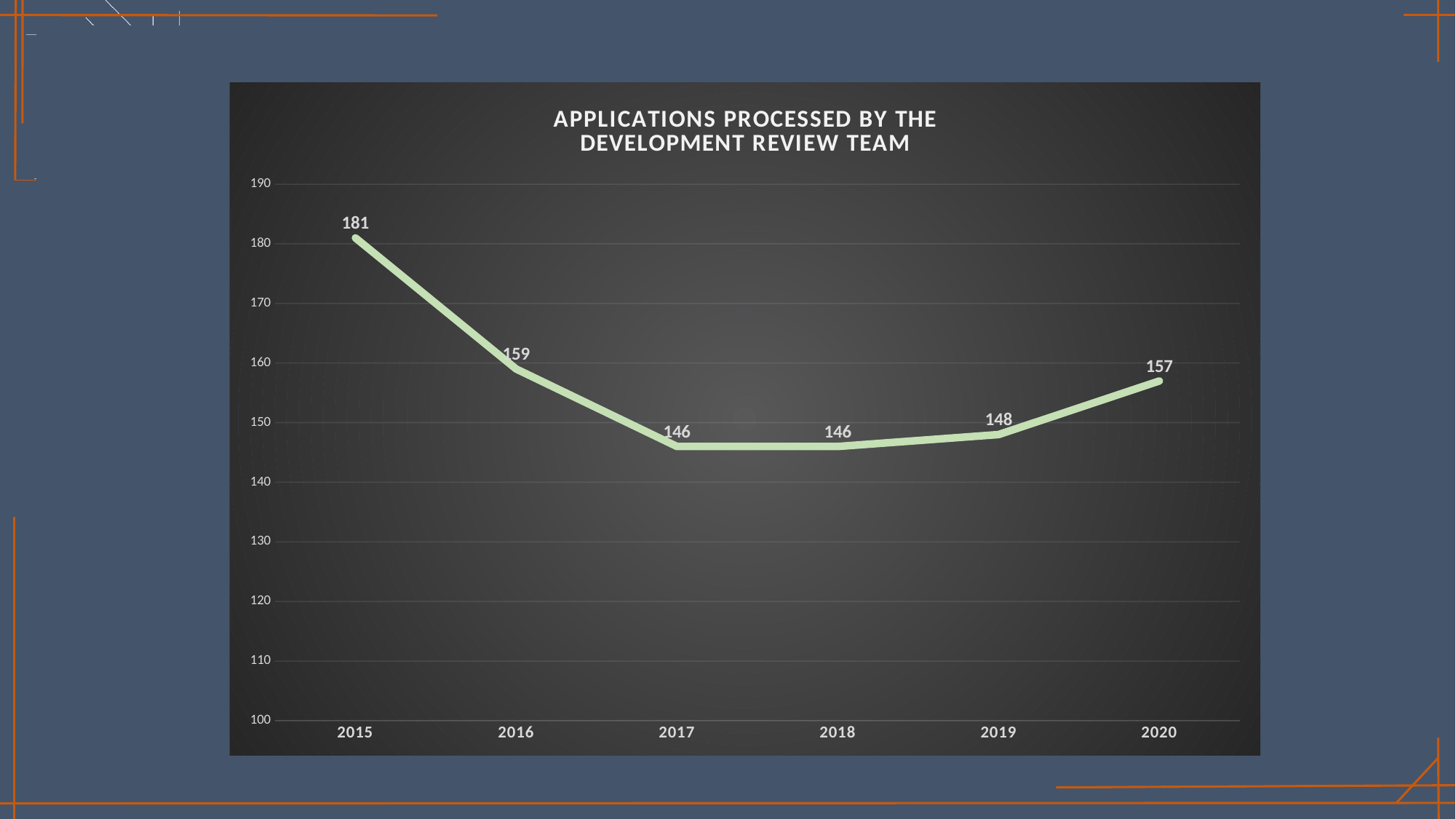
Do the values rise or fall from 2015 to 2017? fall What is the difference between the values for 2020 and 2019? 9 Which year has the highest value? 2015 Is the value for 2017 greater or less than 150? less What is the title of the chart? Applications Processed by the Development Review Team What is the difference between the values for 2015 and 2016? 22 Which is larger, the value for 2016 or the value for 2020? 2016 What is the value for 2018? 146 What kind of chart is this? line chart What is the value for 2020? 157 What is the value for 2015? 181 How many years are plotted on the x axis? 6